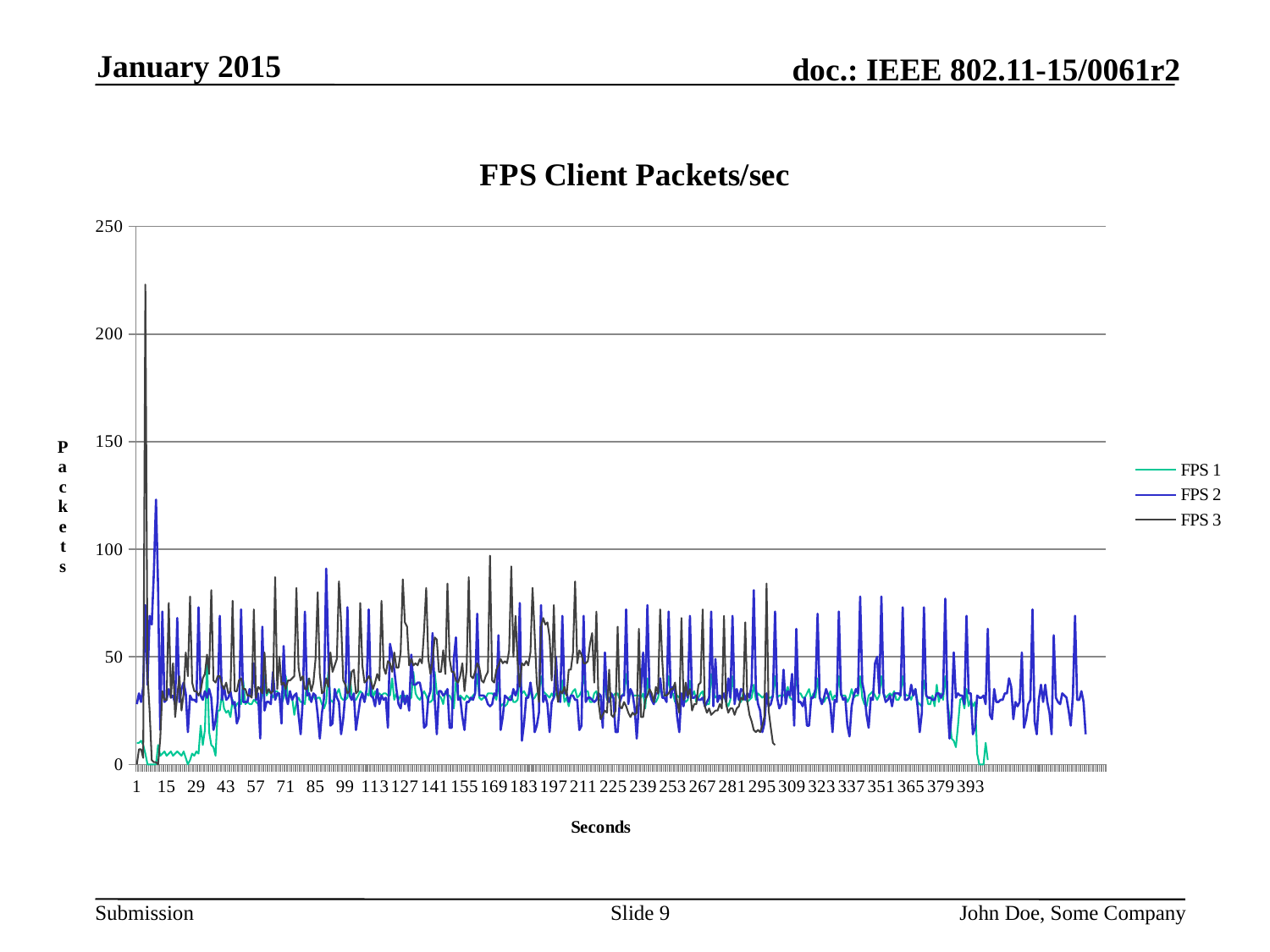
How many series does the legend list? 3 Is the highest value reached by FPS 2 greater or less than 100? greater Is the highest value reached by FPS 3 greater or less than 150? greater What is the highest value shown on the y axis? 250 What is the title of the chart? FPS Client Packets/sec Is the highest value reached by FPS 3 greater or less than 200? greater What kind of chart is shown on the slide? line chart Which series reaches the highest peak value on the chart? FPS 3 What is the label of the x axis? Seconds Which series has the lower values during the first 15 seconds, FPS 1 or FPS 2? FPS 1